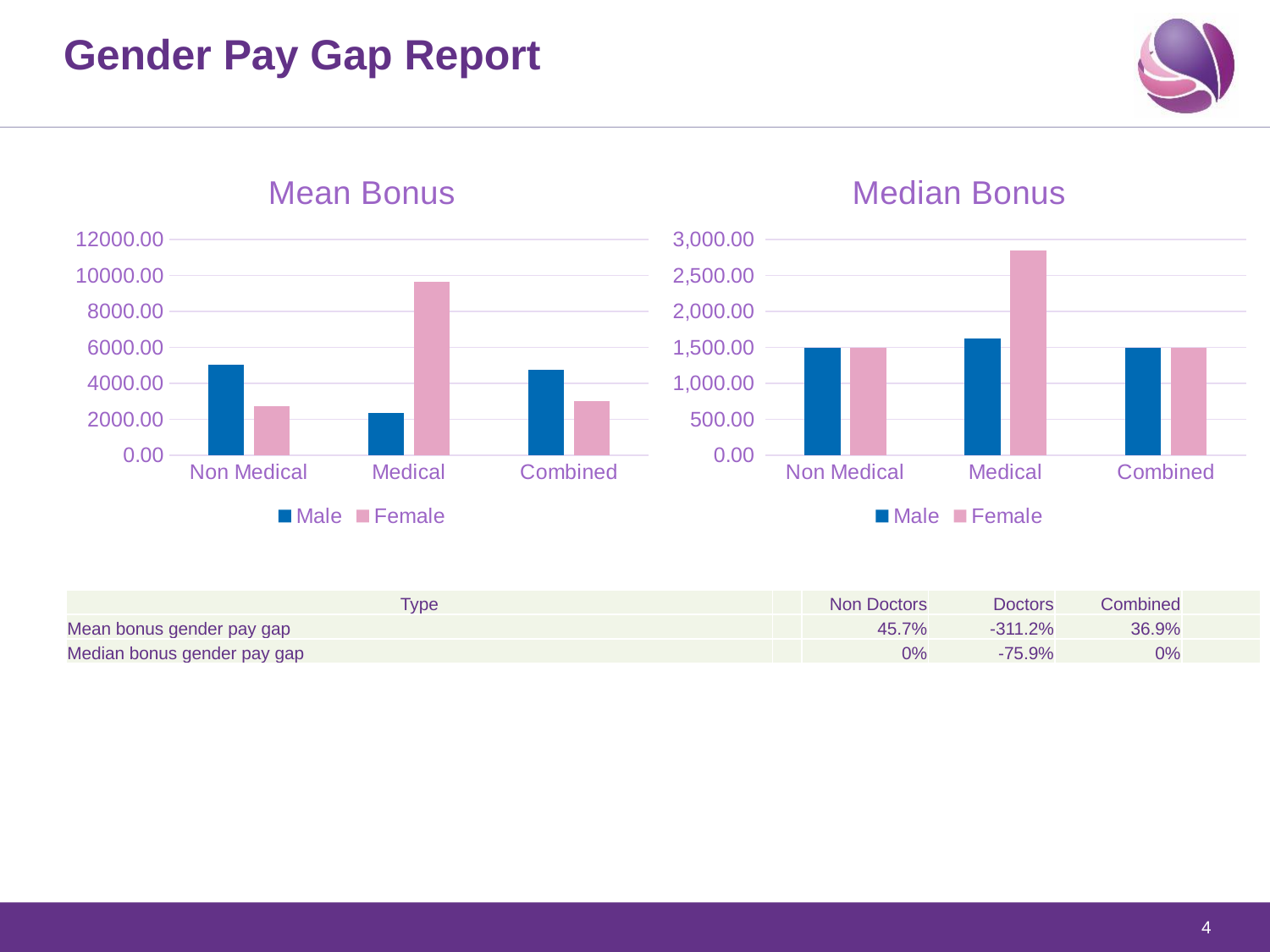
In the Median Bonus chart, for Medical, which is larger: the Male or the Female value? Female In the Mean Bonus chart, which category has the lowest Male bar? Medical In the Mean Bonus chart, which category has the highest Female bar? Medical In the Median Bonus chart, is the Female value for Medical greater or less than 2,500.00? greater In the Mean Bonus chart, for Non Medical, which is larger: the Male or the Female value? Male How many categories are shown on the x axis of the Median Bonus chart? 3 What kind of chart is the Mean Bonus chart? bar chart How many series does the legend of the Mean Bonus chart list? 2 In the Median Bonus chart, which category has the highest Female bar? Medical In the Mean Bonus chart, is the Female value for Medical greater or less than 8000? greater In the Mean Bonus chart, is the Male value for Non Medical greater or less than 4000? greater What are the two legend entries of the Median Bonus chart? Male and Female